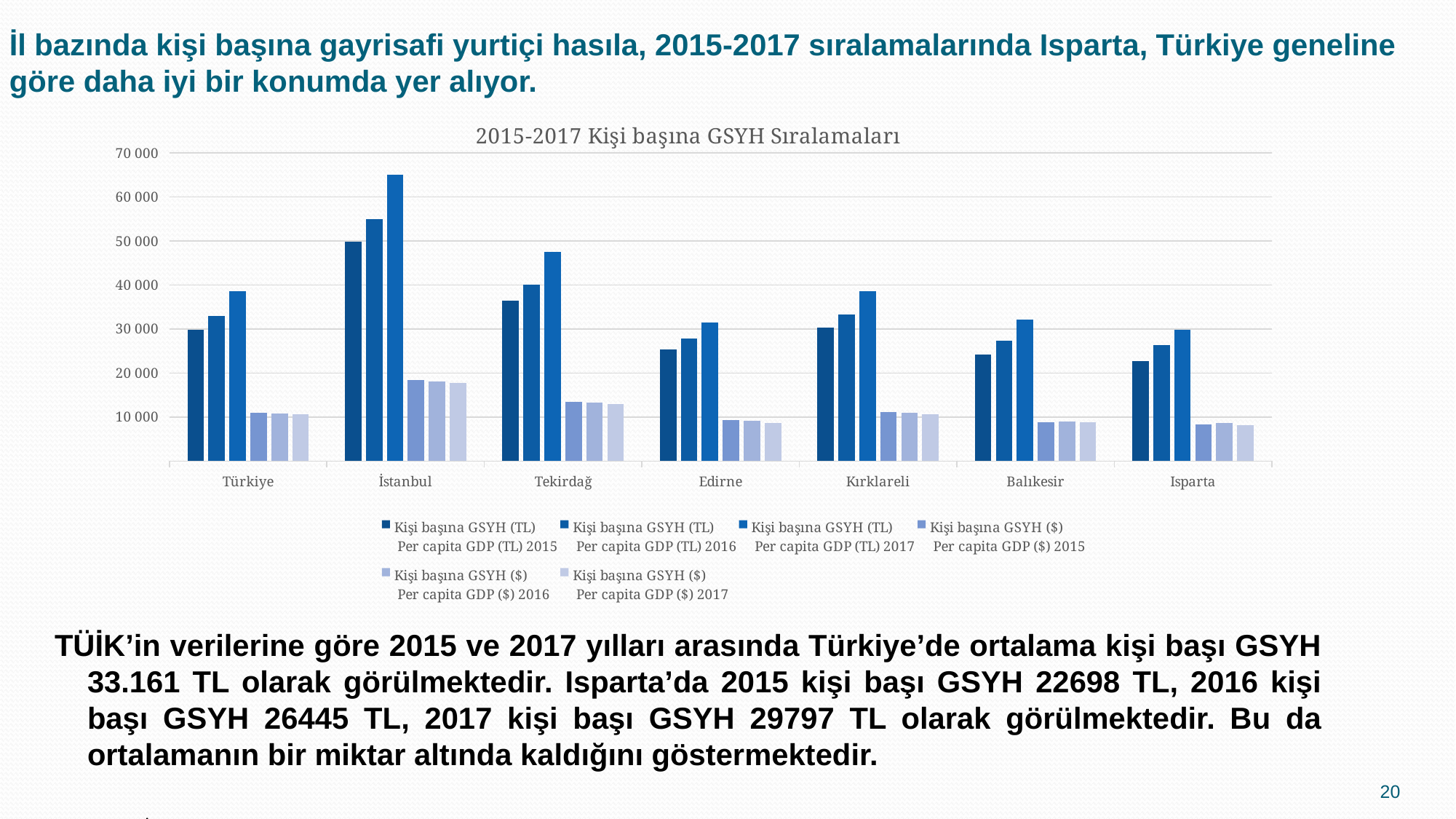
Which is larger: the Per capita GDP (TL) 2015 value for Türkiye or for Edirne? Türkiye Is the value for Edirne in the Per capita GDP (TL) 2015 series greater or less than 30 000? less What is the title of the chart? 2015-2017 Kişi başına GSYH Sıralamaları Is the value for Tekirdağ in the Per capita GDP (TL) 2017 series greater or less than 50 000? less Which is larger: the Per capita GDP (TL) 2017 value for İstanbul or for Tekirdağ? İstanbul Is the value for İstanbul in the Per capita GDP (TL) 2017 series greater or less than 60 000? greater What kind of chart is shown on the slide? bar chart How many categories (provinces/regions) are shown on the x axis of the chart? 7 For Isparta, do the Per capita GDP (TL) values rise or fall from 2015 to 2017? rise How many series does the chart's legend list? 6 Which category has the highest value for Kişi başına GSYH (TL) Per capita GDP (TL) 2017? İstanbul